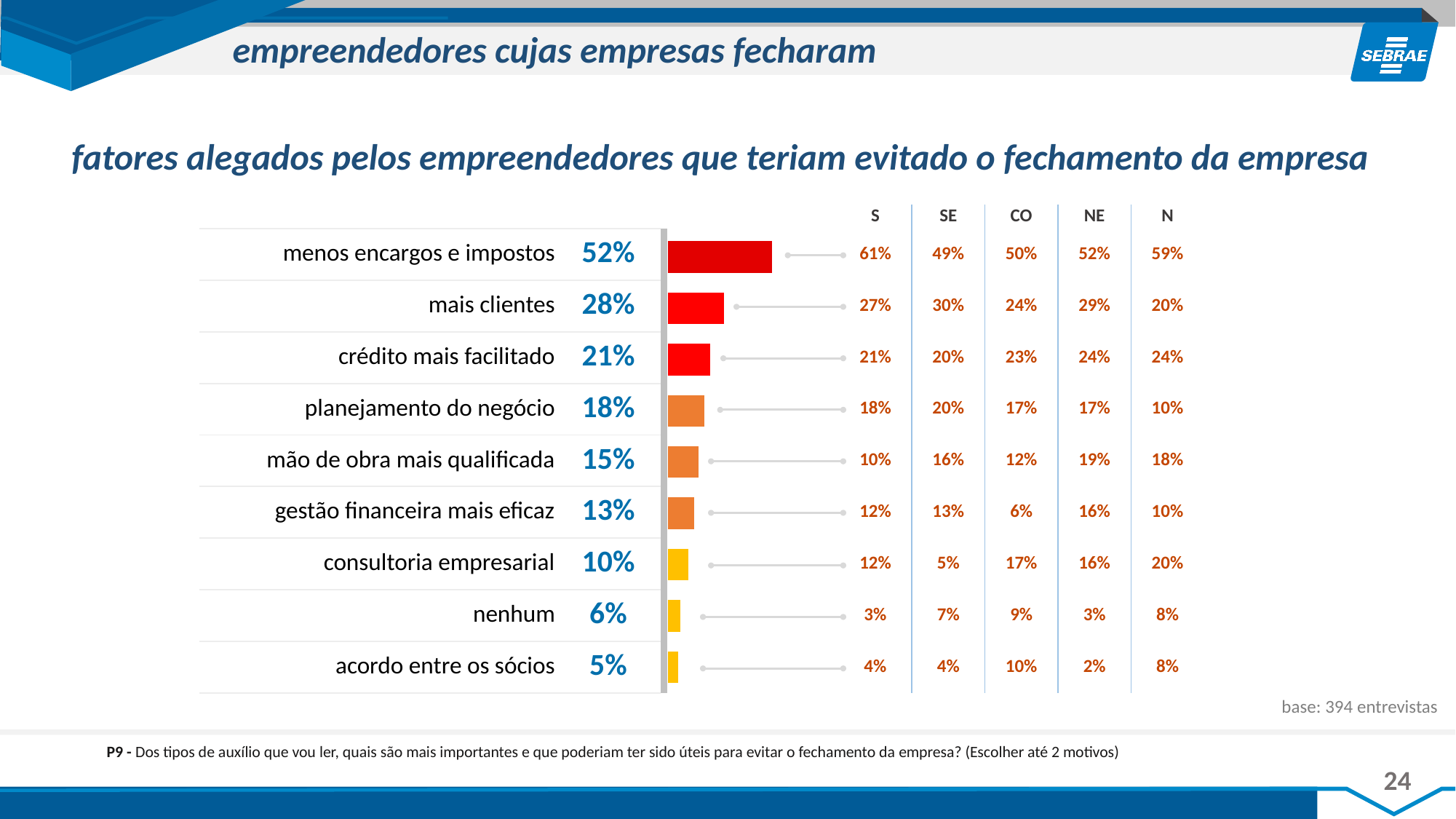
Which category has the highest value? menos encargos e impostos In the regional table, what is the difference between the N and SE values for "consultoria empresarial"? 15% How many categories are shown in the bar chart? 9 Which category has the lowest value? acordo entre os sócios What kind of chart is shown on the slide? bar chart Which is larger, the value for "planejamento do negócio" or the value for "consultoria empresarial"? planejamento do negócio In the regional table, what is the value for "gestão financeira mais eficaz" in the CO column? 6% How many regional columns are shown to the right of the bar chart? 5 What is the difference between the values for "mais clientes" and "crédito mais facilitado"? 7% What is the value for "menos encargos e impostos"? 52% What is the value for "mão de obra mais qualificada"? 15% In the regional table, what is the value for "menos encargos e impostos" in the S column? 61%